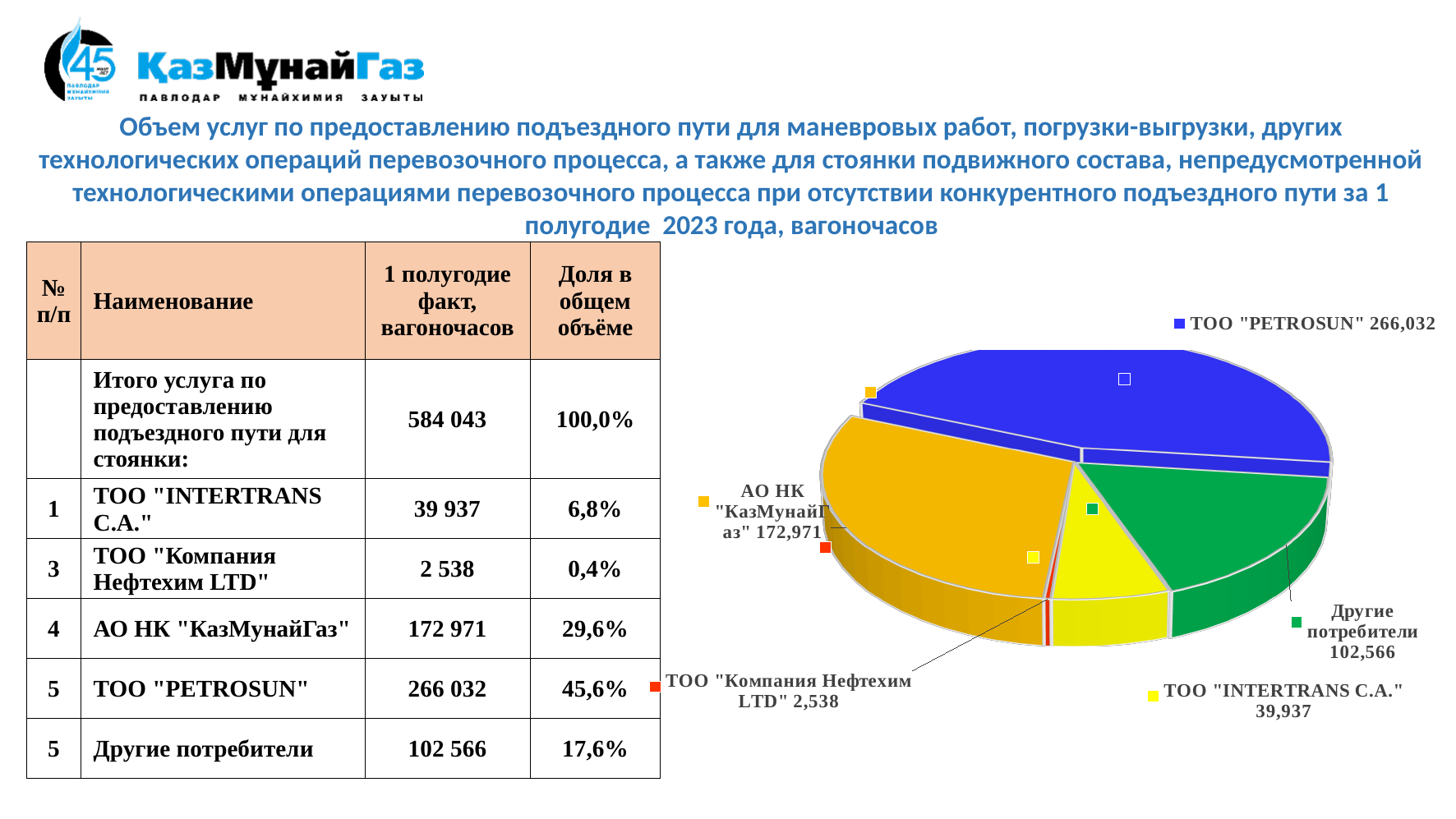
What kind of chart is shown on the slide? Pie chart Which is larger in the pie chart: АО НК "КазМунайГаз" or Другие потребители? АО НК "КазМунайГаз" What value is shown for ТОО "PETROSUN" in the pie chart? 266,032 Which category has the smallest slice in the pie chart? ТОО "Компания Нефтехим LTD" What value is shown for ТОО "Компания Нефтехим LTD" in the pie chart? 2,538 Which category has the largest slice in the pie chart? ТОО "PETROSUN" What value is shown for Другие потребители in the pie chart? 102,566 What value is shown for АО НК "КазМунайГаз" in the pie chart? 172,971 How many slices does the pie chart have? 5 What is the difference between the values for Другие потребители and ТОО "INTERTRANS C.A." in the pie chart? 62,629 What is the difference between the values for ТОО "PETROSUN" and АО НК "КазМунайГаз" in the pie chart? 93,061 What colour is the ТОО "PETROSUN" slice in the pie chart? Blue